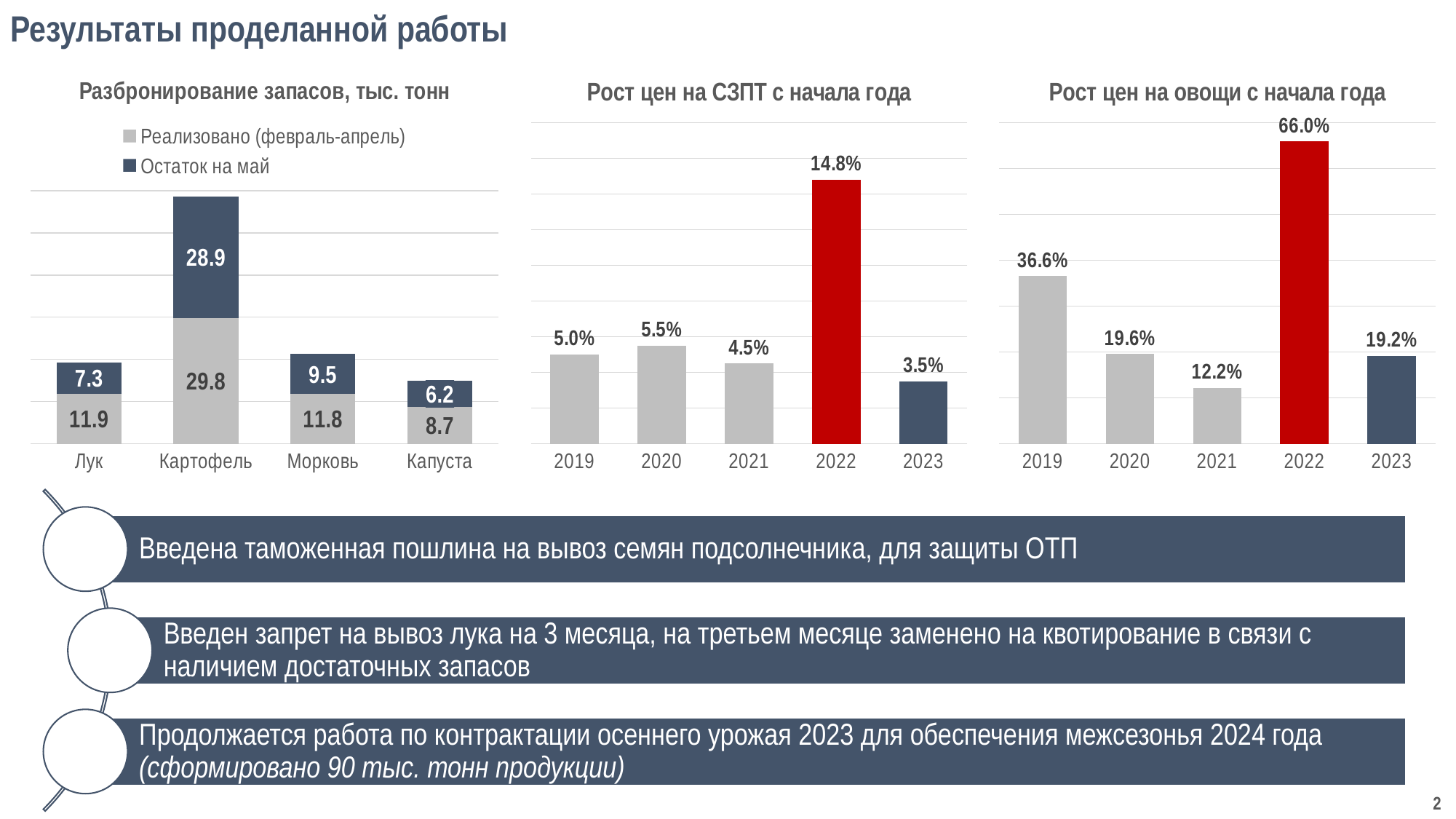
In the chart 'Рост цен на СЗПТ с начала года', what is the value for 2022? 14.8% In the chart 'Рост цен на овощи с начала года', which is larger, the value for 2020 or the value for 2023? 2020 In the chart 'Рост цен на СЗПТ с начала года', what is the difference between the values for 2020 and 2021? 1.0% In the chart 'Рост цен на овощи с начала года', what is the value for 2019? 36.6% In the chart 'Разбронирование запасов, тыс. тонн', which category has the lowest 'Реализовано (февраль-апрель)' value? Капуста How many years are shown on the x axis of the chart 'Рост цен на овощи с начала года'? 5 In the chart 'Разбронирование запасов, тыс. тонн', what is the value of 'Реализовано (февраль-апрель)' for Картофель? 29.8 In the chart 'Разбронирование запасов, тыс. тонн', what is the total of the stacked bar for Лук? 19.2 In the chart 'Разбронирование запасов, тыс. тонн', how many series does the legend list? 2 In the chart 'Рост цен на СЗПТ с начала года', which year has the lowest value? 2023 In the chart 'Разбронирование запасов, тыс. тонн', what is the value of 'Остаток на май' for Морковь? 9.5 In the chart 'Рост цен на овощи с начала года', which year has the highest value? 2022